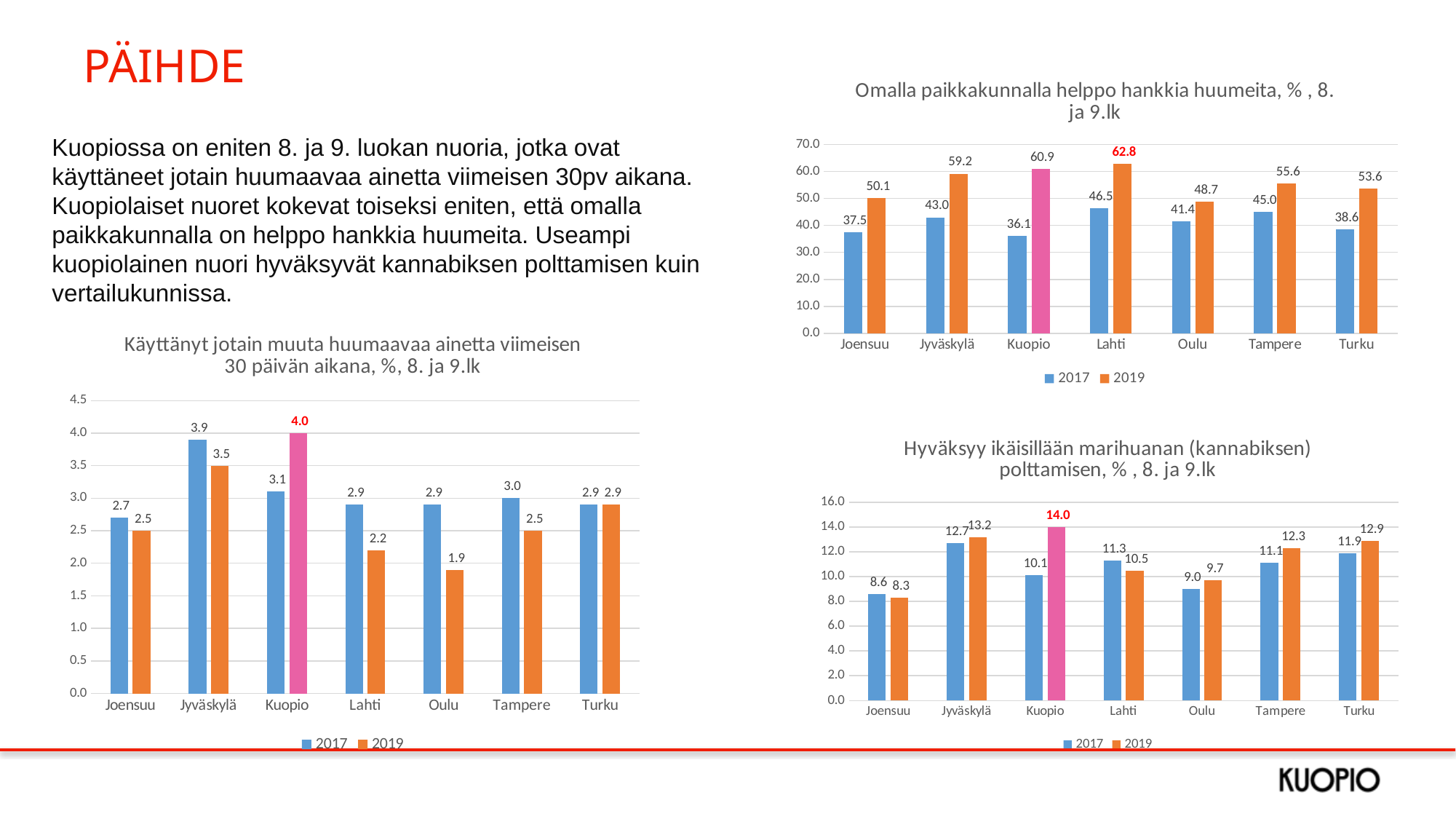
How many series does the legend list in the chart 'Hyväksyy ikäisillään marihuanan (kannabiksen) polttamisen'? 2 In the chart 'Hyväksyy ikäisillään marihuanan (kannabiksen) polttamisen', what is the difference between the 2019 and 2017 values for Kuopio? 3.9 In the chart 'Käyttänyt jotain muuta huumaavaa ainetta viimeisen 30 päivän aikana', what is the difference between the 2017 and 2019 values for Lahti? 0.7 In the chart 'Käyttänyt jotain muuta huumaavaa ainetta viimeisen 30 päivän aikana', what is the 2019 value for Kuopio? 4.0 In the chart 'Hyväksyy ikäisillään marihuanan (kannabiksen) polttamisen', what is the 2019 value for Turku? 12.9 In the chart 'Omalla paikkakunnalla helppo hankkia huumeita', what is the 2017 value for Kuopio? 36.1 In the chart 'Käyttänyt jotain muuta huumaavaa ainetta viimeisen 30 päivän aikana', which city has the highest 2017 value? Jyväskylä In the chart 'Omalla paikkakunnalla helppo hankkia huumeita', which city has the highest 2019 value? Lahti In the chart 'Käyttänyt jotain muuta huumaavaa ainetta viimeisen 30 päivän aikana', which city has the lowest 2019 value? Oulu In the chart 'Omalla paikkakunnalla helppo hankkia huumeita', which is larger: the 2019 value for Jyväskylä or the 2019 value for Tampere? Jyväskylä In the chart 'Omalla paikkakunnalla helppo hankkia huumeita', how many cities are shown on the x axis? 7 In the chart 'Hyväksyy ikäisillään marihuanan (kannabiksen) polttamisen', which city has the lowest 2019 value? Joensuu